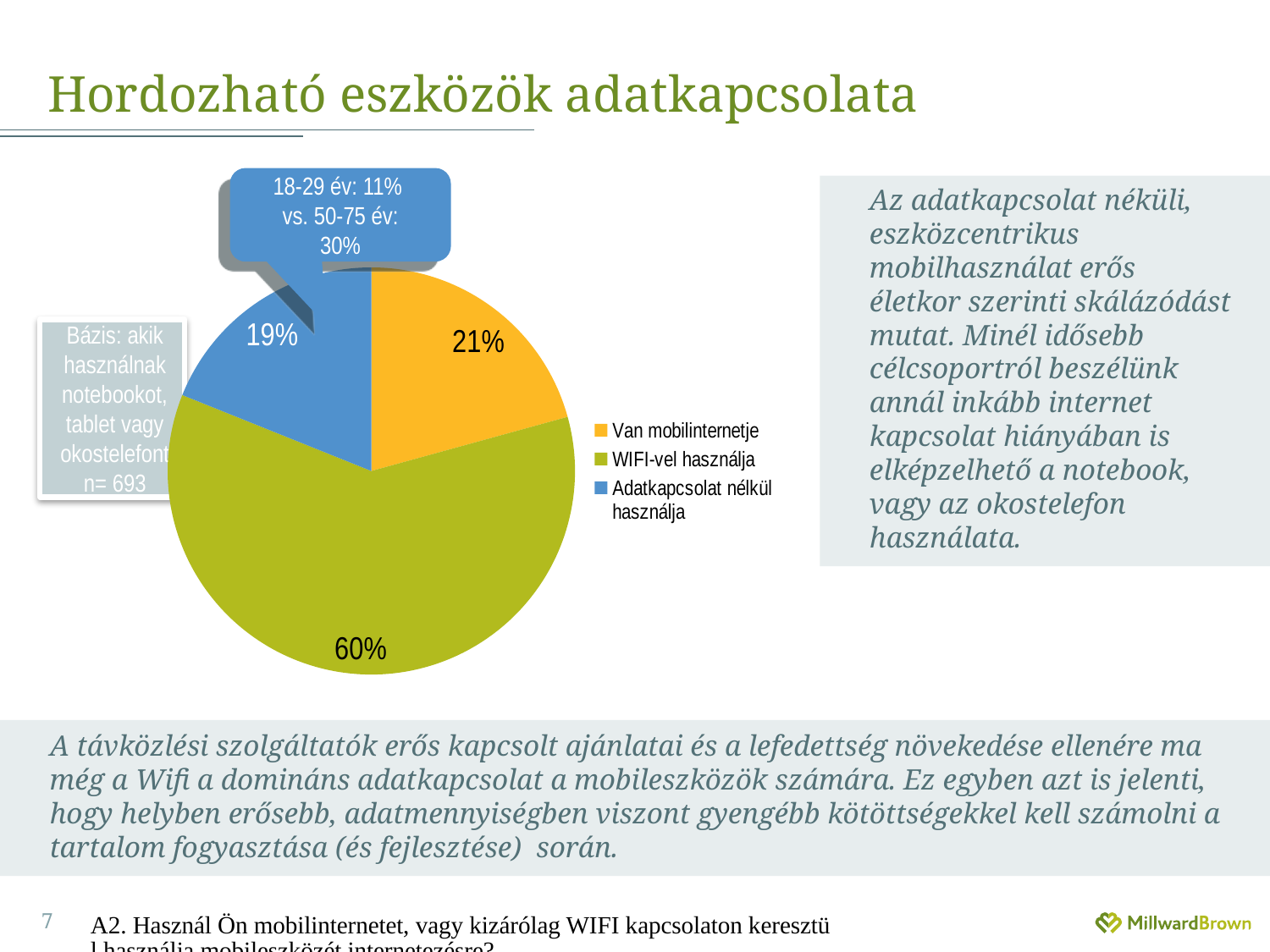
Which category has the largest slice of the pie? WIFI-vel használja Which category has the smallest slice of the pie? Adatkapcsolat nélkül használja How many entries does the legend list? 3 What share of the pie is labelled "Adatkapcsolat nélkül használja"? 19% What is the difference in percentage points between the "WIFI-vel használja" slice and the "Van mobilinternetje" slice? 39 percentage points Which is larger: the "Van mobilinternetje" slice or the "Adatkapcsolat nélkül használja" slice? Van mobilinternetje What kind of chart is shown on the slide? pie chart What colour is the "WIFI-vel használja" slice? green What share of the pie is labelled "WIFI-vel használja"? 60% According to the callout on the chart, what is the value for the 50-75 age group? 30% How many slices does the pie chart have? 3 What share of the pie is labelled "Van mobilinternetje"? 21%